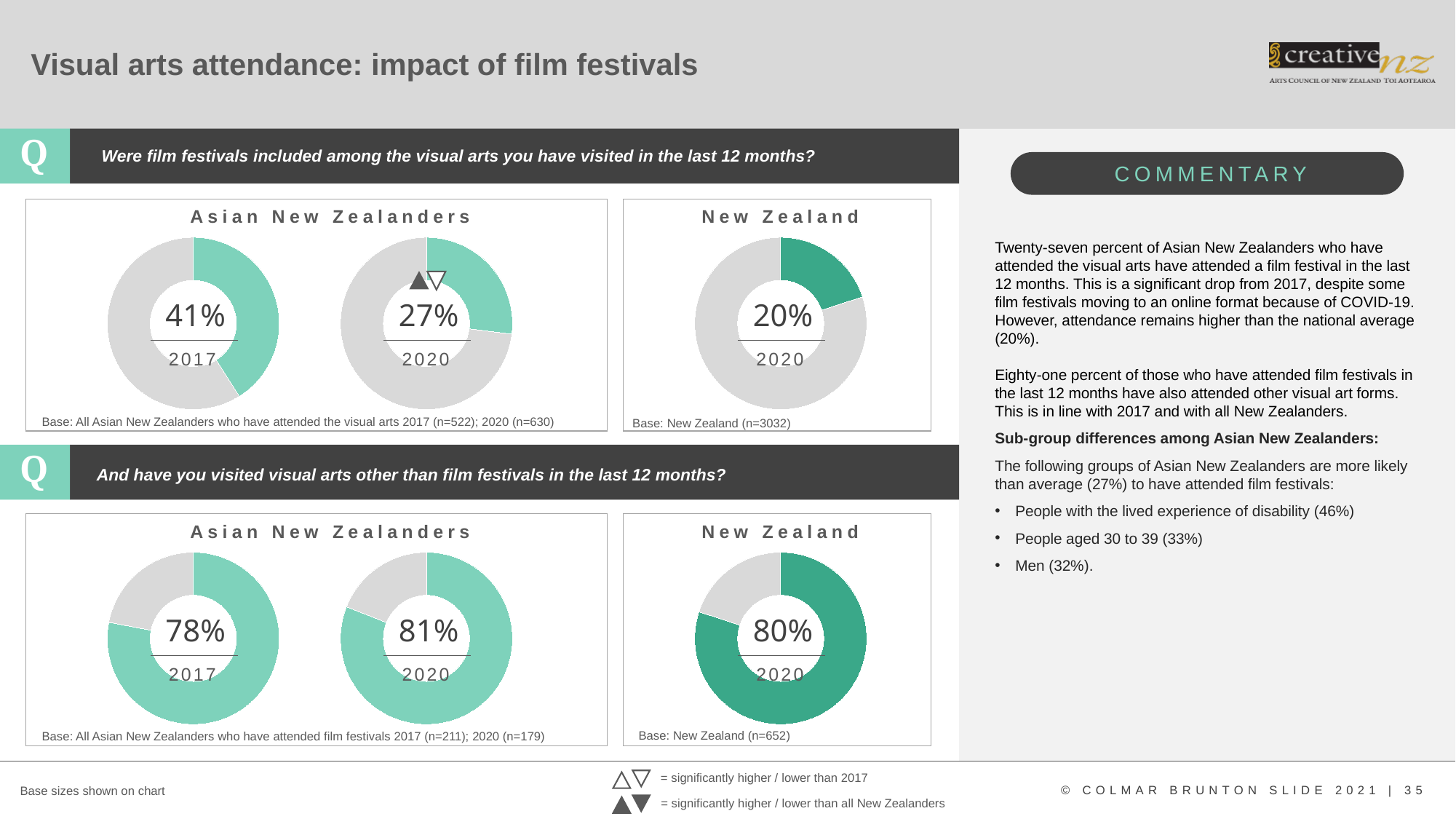
In the top 'Asian New Zealanders' chart (film festivals), by how many percentage points did the value fall from 2017 to 2020? 14 percentage points In the bottom 'Asian New Zealanders' chart (visual arts other than film festivals), did the value rise or fall from 2017 to 2020? Rise How many donut charts are shown on the slide in total? 6 In the top row of charts, which is larger for 2020: the Asian New Zealanders film festival value or the New Zealand film festival value? Asian New Zealanders (27%) In the top 'Asian New Zealanders' chart (film festivals), what percentage is shown for 2017? 41% What type of chart is used to show the percentages on this slide? Donut (pie) chart In the top 'Asian New Zealanders' chart (film festivals), did the value rise or fall from 2017 to 2020? Fall In the bottom 'New Zealand' chart (visual arts other than film festivals), what percentage is shown for 2020? 80% In the top 'New Zealand' chart (film festivals), what percentage is shown for 2020? 20% In the bottom 'Asian New Zealanders' chart (visual arts other than film festivals), what percentage is shown for 2017? 78% In the top 'Asian New Zealanders' chart (film festivals), what percentage is shown for 2020? 27% In the bottom 'Asian New Zealanders' chart (visual arts other than film festivals), what percentage is shown for 2020? 81%